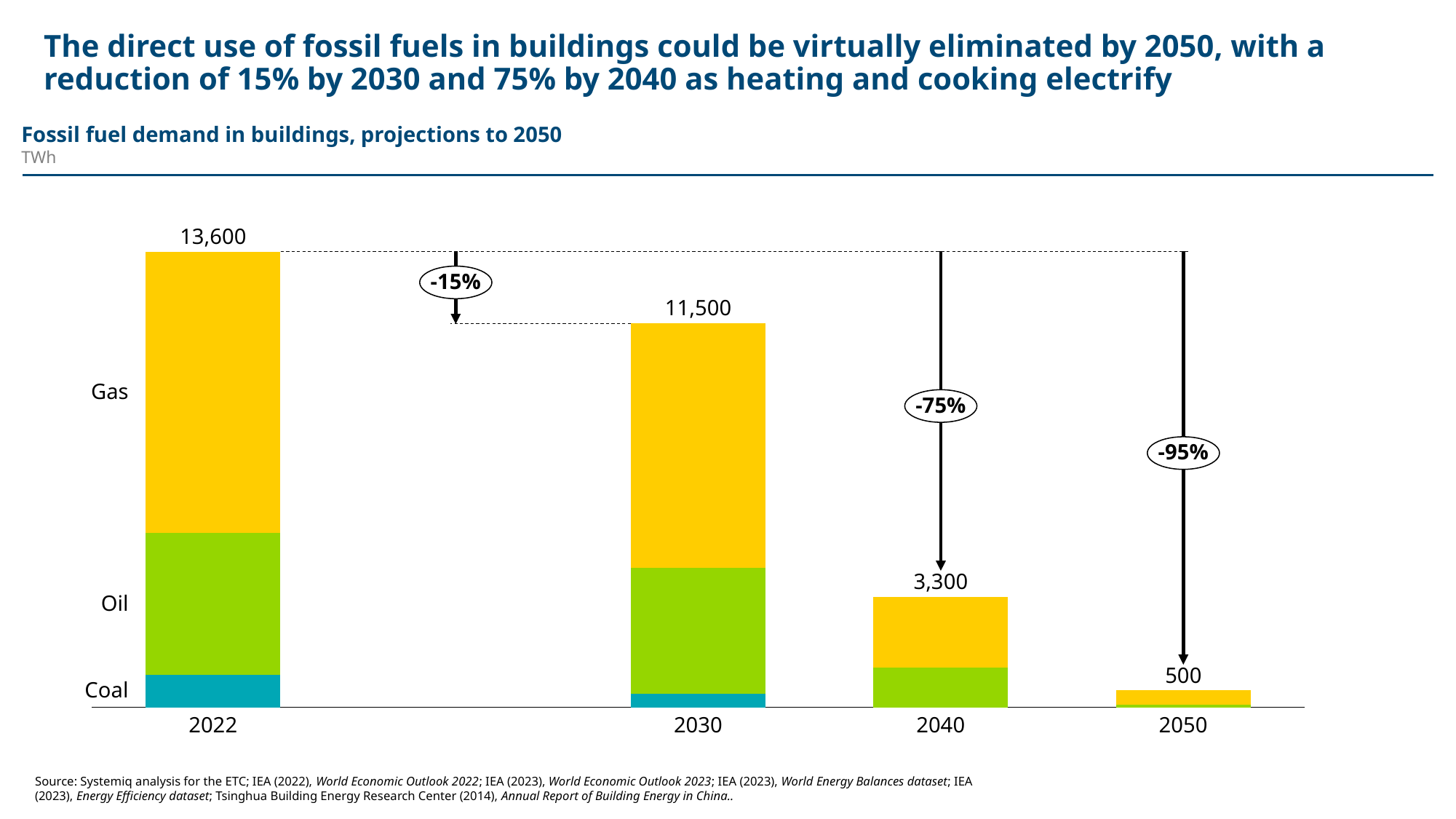
How many years are shown on the x axis of the chart? 4 What is the difference between the total for 2030 and the total for 2040? 8,200 What is the difference between the total for 2022 and the total for 2030? 2,100 What kind of chart is shown on the slide? stacked bar chart What is the total fossil fuel demand in buildings shown for 2050? 500 What is the total fossil fuel demand in buildings shown for 2030? 11,500 Which year has the lowest total fossil fuel demand in buildings? 2050 What is the total fossil fuel demand in buildings shown for 2040? 3,300 What is the total fossil fuel demand in buildings shown for 2022? 13,600 What percentage reduction is labelled between 2022 and 2040? -75% Which year has the highest total fossil fuel demand in buildings? 2022 Is the total for 2040 larger or smaller than the total for 2030? smaller